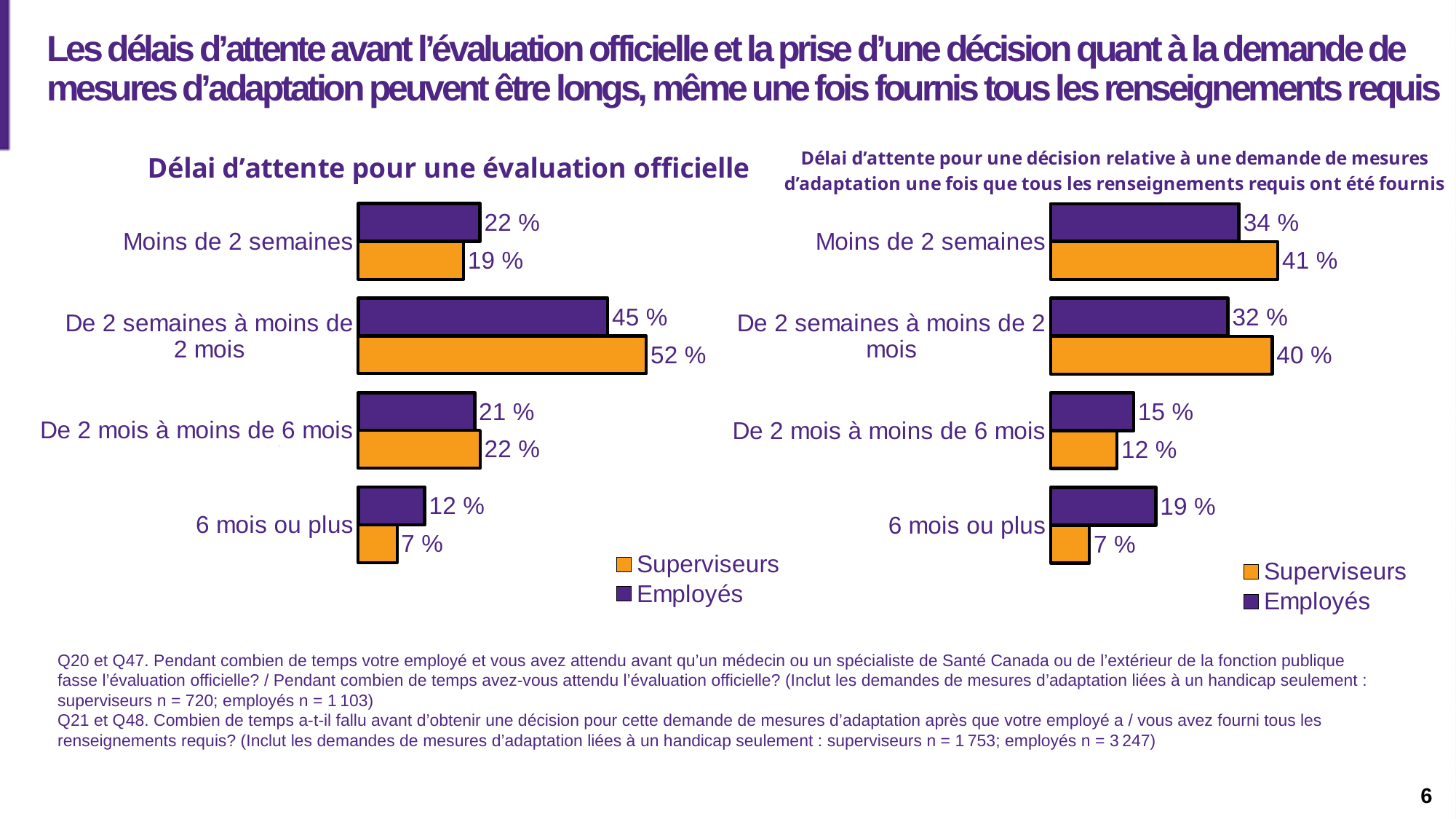
In the right-hand chart (Délai d'attente pour une décision relative à une demande de mesures d'adaptation), what is the value for Superviseurs in the category "Moins de 2 semaines"? 41 % How many series does the legend of the right-hand chart list? 2 In the chart titled "Délai d'attente pour une évaluation officielle", what is the value for Superviseurs in the category "De 2 semaines à moins de 2 mois"? 52 % In the chart titled "Délai d'attente pour une évaluation officielle", which category has the highest value for Employés? De 2 semaines à moins de 2 mois What kind of chart is the chart titled "Délai d'attente pour une évaluation officielle"? Bar chart In the right-hand chart (Délai d'attente pour une décision relative à une demande de mesures d'adaptation), what is the difference between the Employés and Superviseurs values for "6 mois ou plus"? 12 % In the right-hand chart (Délai d'attente pour une décision relative à une demande de mesures d'adaptation), which category has the lowest value for Superviseurs? 6 mois ou plus In the chart titled "Délai d'attente pour une évaluation officielle", what is the value for Employés in the category "6 mois ou plus"? 12 % In the right-hand chart (Délai d'attente pour une décision relative à une demande de mesures d'adaptation), what is the value for Employés in the category "De 2 mois à moins de 6 mois"? 15 % In the right-hand chart (Délai d'attente pour une décision relative à une demande de mesures d'adaptation), which is larger for "Moins de 2 semaines": Superviseurs or Employés? Superviseurs In the chart titled "Délai d'attente pour une évaluation officielle", what is the difference between the Superviseurs and Employés values for "De 2 semaines à moins de 2 mois"? 7 % How many categories does the chart titled "Délai d'attente pour une évaluation officielle" show? 4